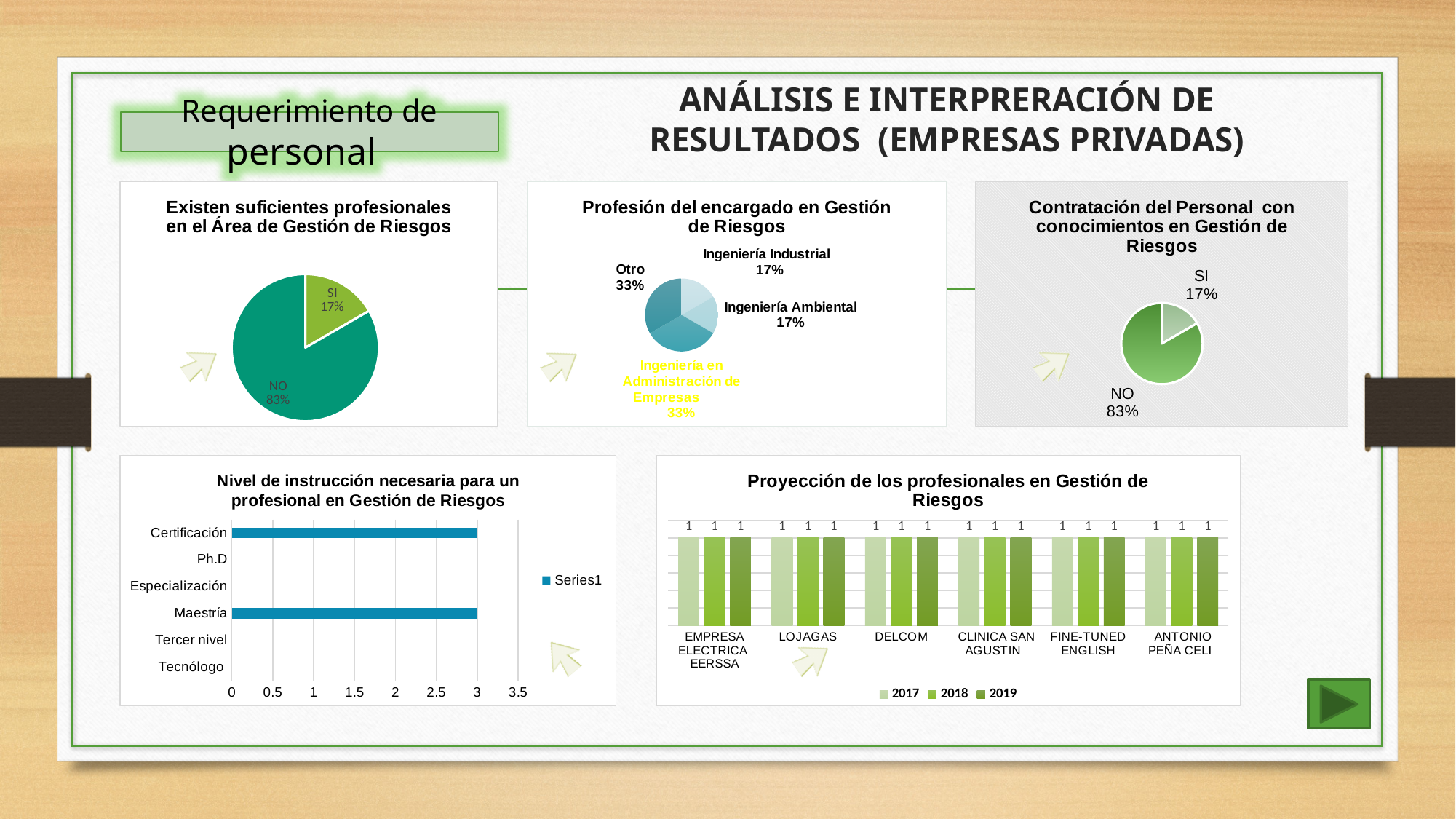
In the chart 'Profesión del encargado en Gestión de Riesgos', what is the share for Ingeniería Industrial? 17% In the chart 'Nivel de instrucción necesaria para un profesional en Gestión de Riesgos', what kind of chart is shown? Bar chart In the chart 'Nivel de instrucción necesaria para un profesional en Gestión de Riesgos', what is the value for Certificación? 3 In the chart 'Existen suficientes profesionales en el Área de Gestión de Riesgos', what kind of chart is shown? Pie chart In the chart 'Contratación del Personal con conocimientos en Gestión de Riesgos', what is the share for SI? 17% In the chart 'Profesión del encargado en Gestión de Riesgos', what is the share for Ingeniería en Administración de Empresas? 33% In the chart 'Contratación del Personal con conocimientos en Gestión de Riesgos', which slice is larger, SI or NO? NO In the chart 'Nivel de instrucción necesaria para un profesional en Gestión de Riesgos', how many categories are listed on the vertical axis? 6 In the chart 'Proyección de los profesionales en Gestión de Riesgos', how many series does the legend list? 3 In the chart 'Proyección de los profesionales en Gestión de Riesgos', what is the value for LOJAGAS in 2019? 1 In the chart 'Profesión del encargado en Gestión de Riesgos', how many slices does the pie have? 4